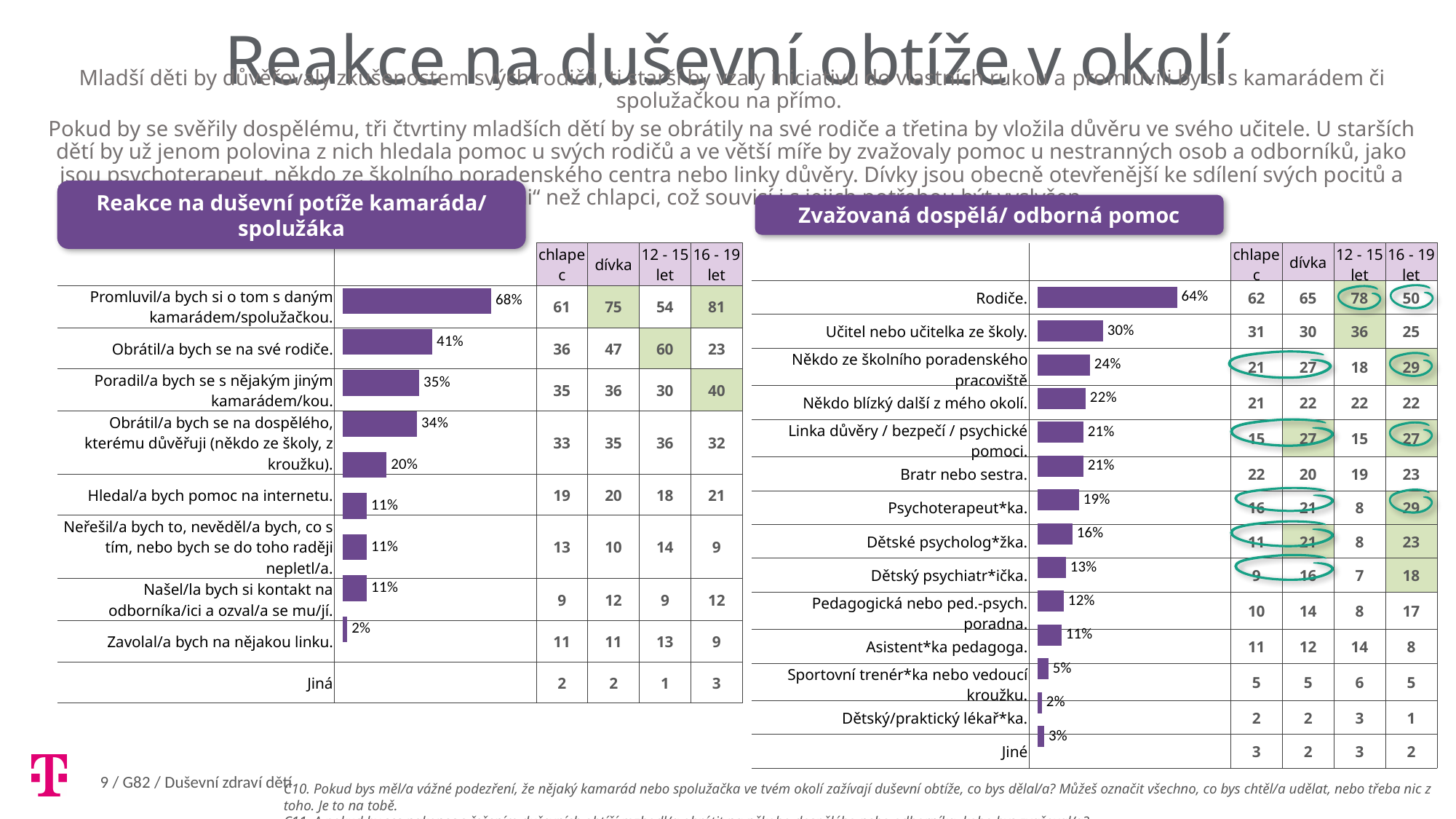
In the 'Zvažovaná dospělá/ odborná pomoc' chart, what is the value for 'Učitel nebo učitelka ze školy.'? 30% In the 'Zvažovaná dospělá/ odborná pomoc' chart, what is the difference between 'Rodiče.' (64%) and 'Učitel nebo učitelka ze školy.' (30%)? 34 percentage points How many categories are listed in the 'Zvažovaná dospělá/ odborná pomoc' chart? 14 In the 'Zvažovaná dospělá/ odborná pomoc' chart, which category has the highest value? Rodiče. In the 'Zvažovaná dospělá/ odborná pomoc' chart, what is the value for 'Rodiče.'? 64% In the table next to the 'Zvažovaná dospělá/ odborná pomoc' chart, what is the value for 'Rodiče.' in the '12 - 15 let' column? 78 In the 'Reakce na duševní potíže kamaráda/ spolužáka' chart, what is the value for 'Obrátil/a bych se na své rodiče.'? 41% In the 'Reakce na duševní potíže kamaráda/ spolužáka' chart, which category has the highest value? Promluvil/a bych si o tom s daným kamarádem/spolužačkou. In the 'Reakce na duševní potíže kamaráda/ spolužáka' chart, what is the value for 'Promluvil/a bych si o tom s daným kamarádem/spolužačkou.'? 68% In the 'Zvažovaná dospělá/ odborná pomoc' chart, which is larger: 'Rodiče.' or 'Učitel nebo učitelka ze školy.'? Rodiče. What kind of chart is the 'Reakce na duševní potíže kamaráda/ spolužáka' chart on the left? bar chart In the 'Reakce na duševní potíže kamaráda/ spolužáka' chart, what is the difference between 'Promluvil/a bych si o tom s daným kamarádem/spolužačkou.' (68%) and 'Obrátil/a bych se na své rodiče.' (41%)? 27 percentage points